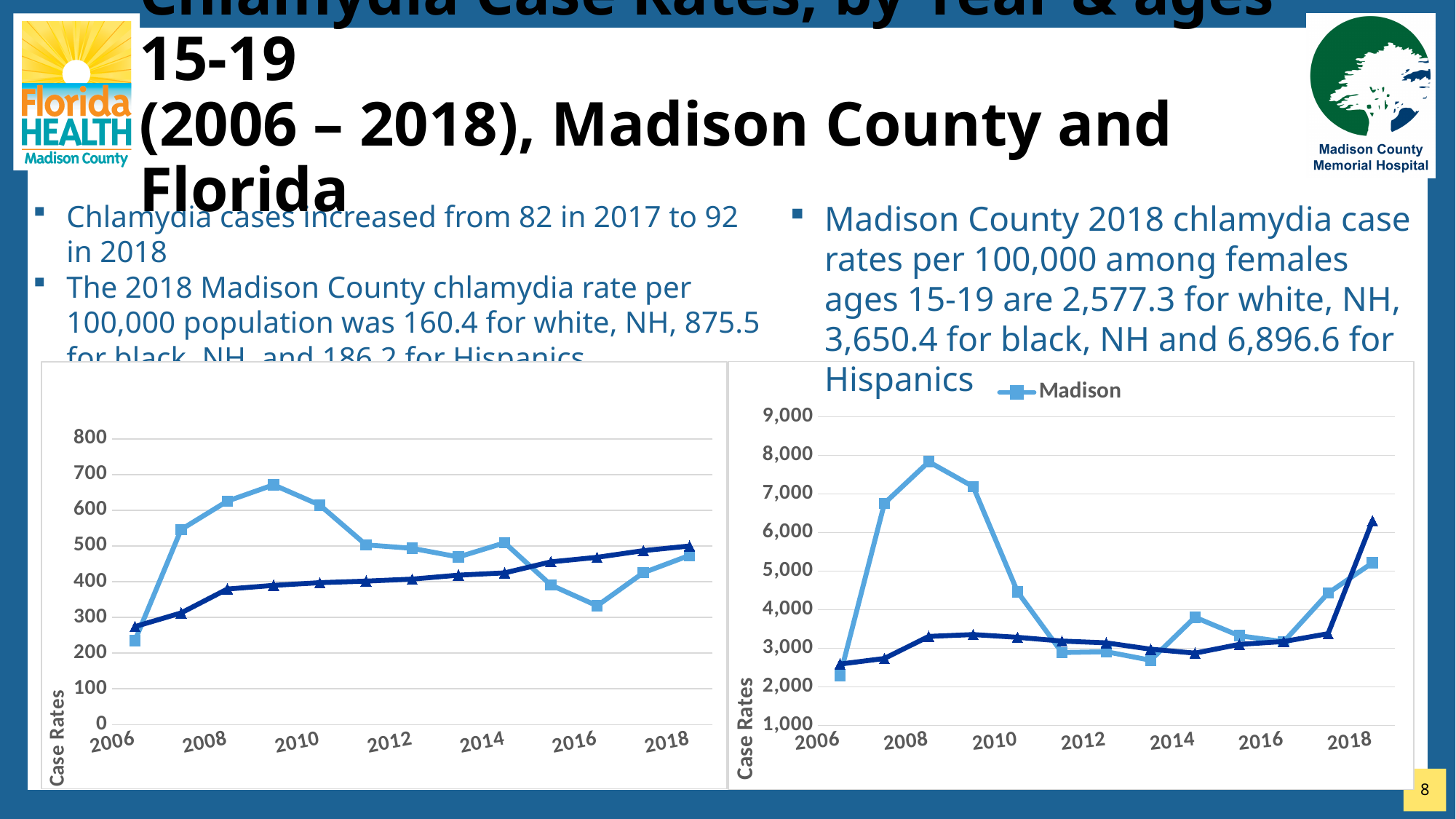
In the chart on the left, is the light blue line's value for 2009 greater or less than 600? greater In the chart on the right, in 2018, which line is higher: the light blue Madison line or the dark blue line? the dark blue line In the chart on the right, which series is named in the legend? Madison In the chart on the right, is the Madison value for 2018 greater or less than 5,000? greater In the chart on the left, how many yearly data points does each line have from 2006 to 2018? 13 What kind of chart is the chart on the left of the slide? line chart In the chart on the left, in which year does the light blue line reach its highest value? 2009 In the chart on the left, is the light blue line's value for 2016 greater or less than 400? less In the chart on the right, in which year does the Madison line reach its highest value? 2008 In the chart on the left, does the dark blue line generally rise or fall from 2006 to 2018? rise